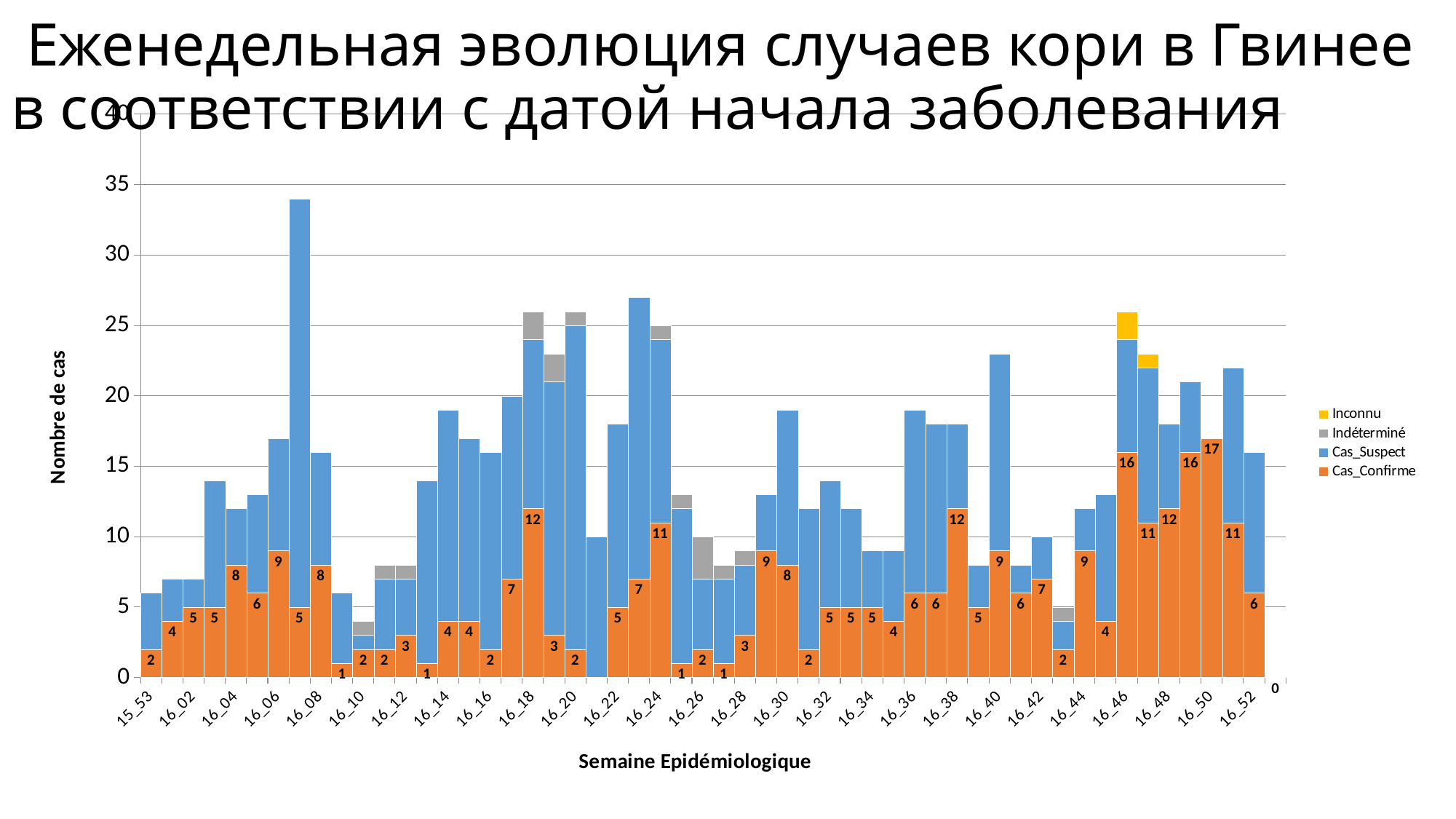
How many series does the legend list? 4 What kind of chart is shown on the slide? stacked bar chart What is the difference between the Cas_Confirme values for weeks 16_46 and 16_38? 4 Is the total height of the bar for week 16_22 greater or less than 15? greater Is the total height of the bar for week 16_40 greater or less than 20? greater What is the Cas_Confirme value for week 15_53? 2 What is the Cas_Confirme value for week 16_18? 12 Which has the larger Cas_Confirme value, week 16_24 or week 16_30? 16_24 What is the Cas_Confirme value for week 16_46? 16 Which labelled week has the highest Cas_Confirme value? 16_50 Which legend entry is shown in yellow? Inconnu What is the Cas_Confirme value for week 16_50? 17